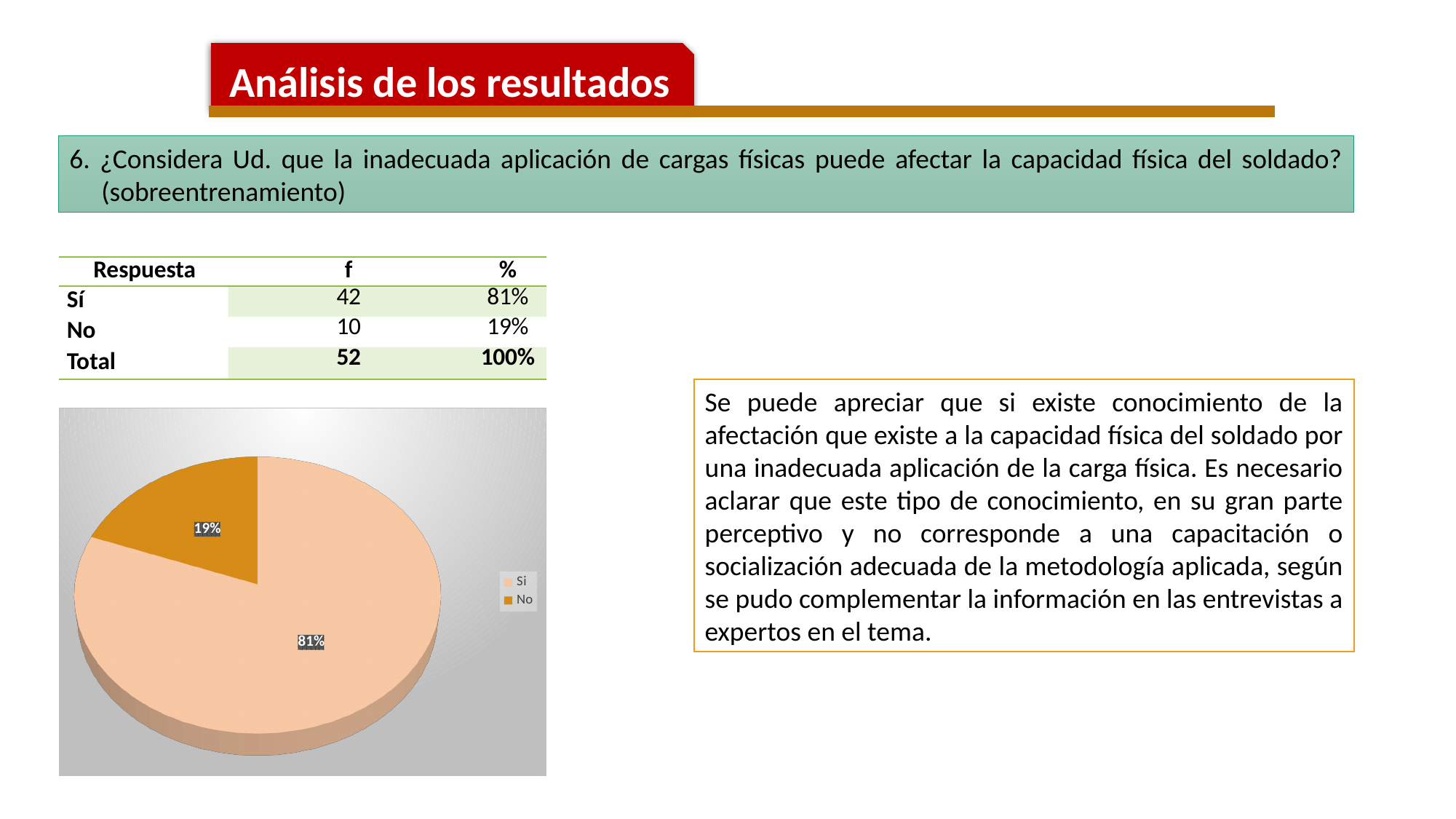
Which slice of the pie chart is the smallest? No What is the difference in percentage points between the "Si" and "No" slices? 62 Which is larger in the pie chart, "Si" or "No"? Si What percentage does the "No" slice of the pie chart show? 19% What percentage does the "Si" slice of the pie chart show? 81% Which slice of the pie chart is the largest? Si What are the two legend entries of the pie chart? Si, No What colour is the "No" slice in the pie chart? orange What share of the pie does the "Si" slice represent? 81% How many entries does the legend of the pie chart list? 2 How many slices does the pie chart have? 2 What kind of chart is shown on the slide? pie chart